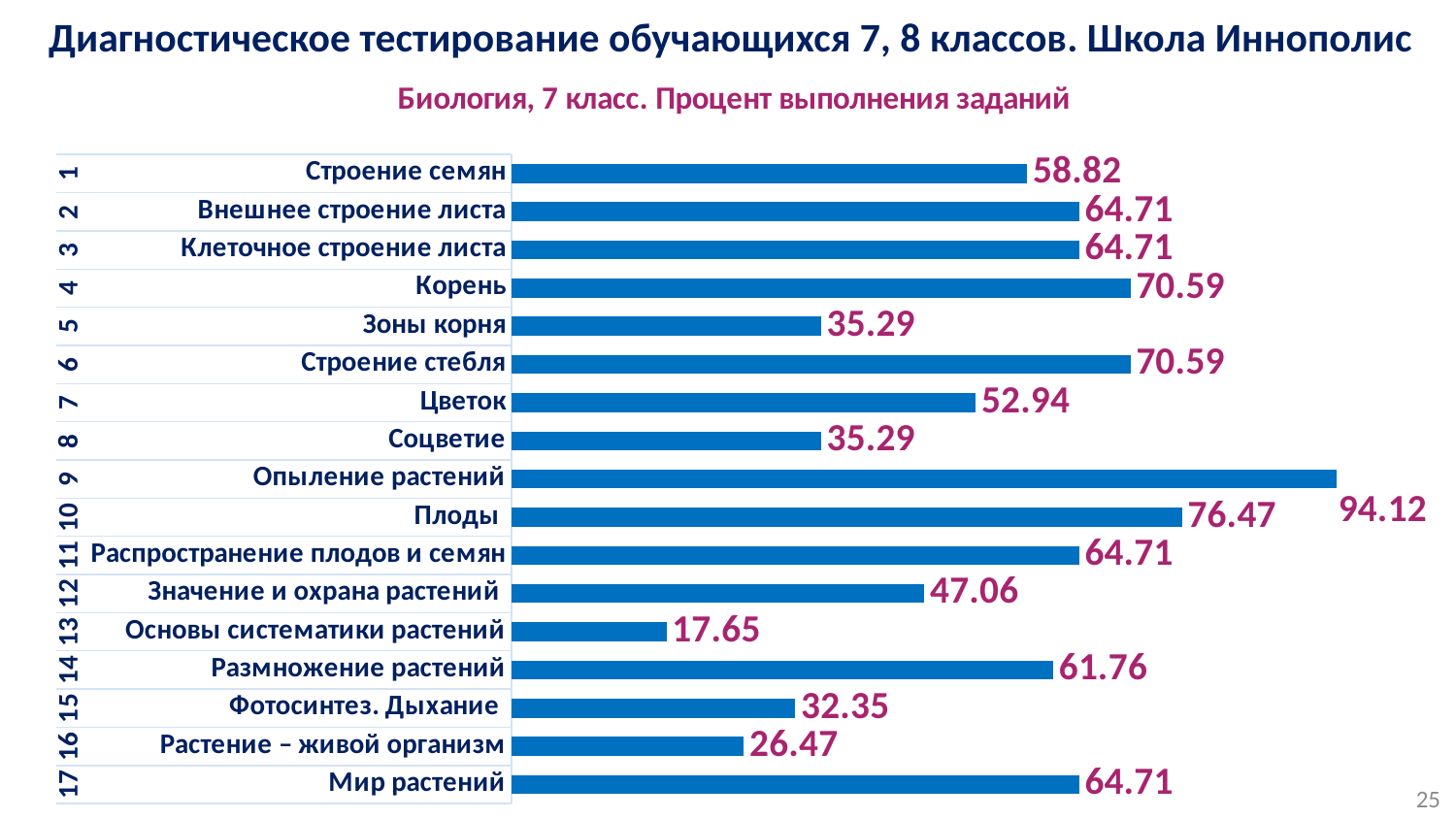
What is the difference between the values for Корень and Зоны корня? 35.30 How many categories are shown in the chart? 17 What is the title of the chart? Биология, 7 класс. Процент выполнения заданий Which category has the lowest value? Основы систематики растений What is the difference between the values for Плоды and Цветок? 23.53 What is the value for Цветок? 52.94 What is the value for Опыление растений? 94.12 What is the value for Основы систематики растений? 17.65 Which is larger, the value for Фотосинтез. Дыхание or the value for Растение – живой организм? Фотосинтез. Дыхание Which category has the highest value? Опыление растений What kind of chart is shown on the slide? Bar chart What is the value for Размножение растений? 61.76